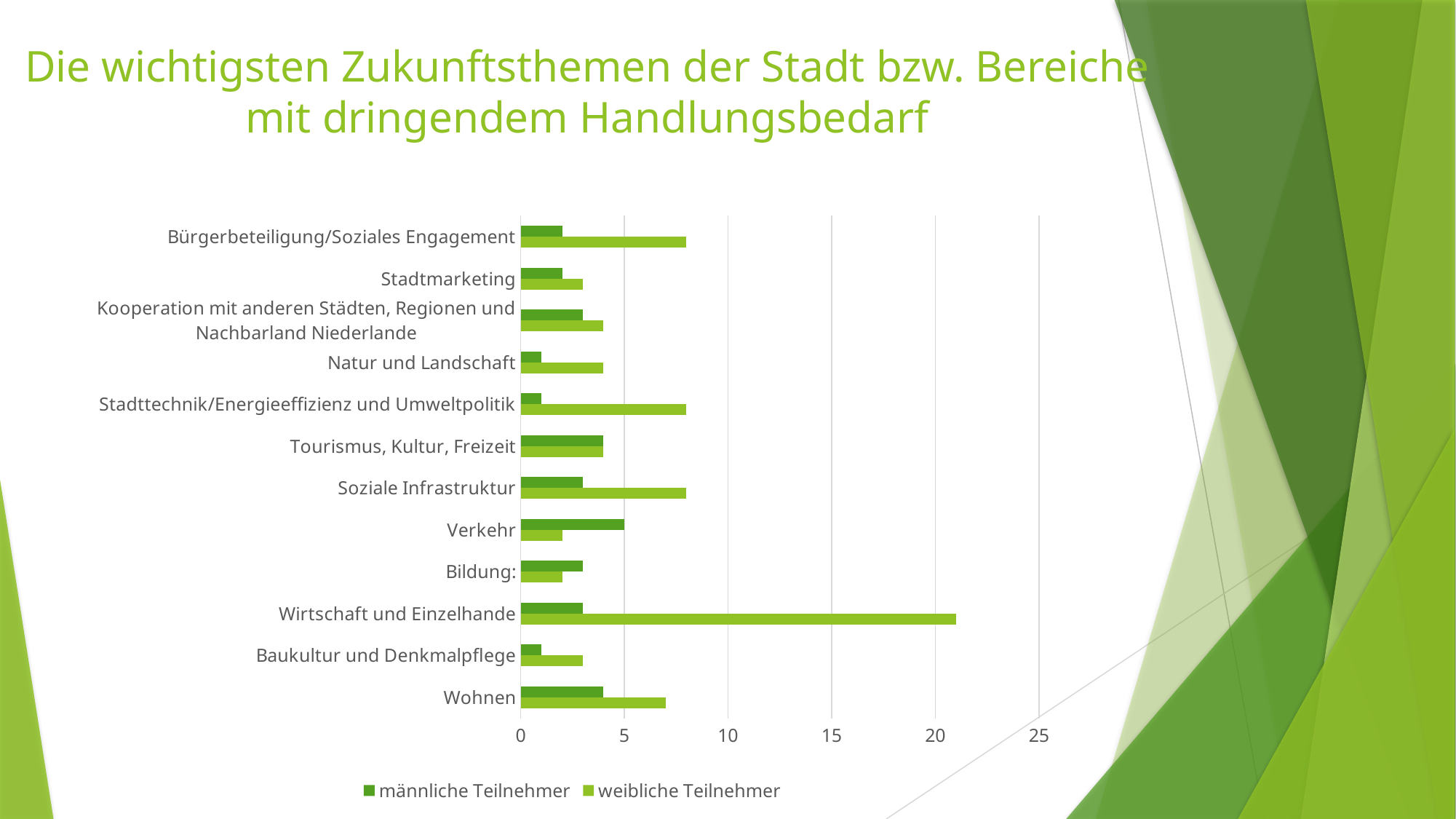
Is the value for weibliche Teilnehmer in Wirtschaft und Einzelhande greater or less than 20? greater Is the value for männliche Teilnehmer in Natur und Landschaft greater or less than 5? less Which category has the longest bar for weibliche Teilnehmer? Wirtschaft und Einzelhande What kind of chart is shown on the slide? bar chart For Bürgerbeteiligung/Soziales Engagement, which series has the larger value, männliche Teilnehmer or weibliche Teilnehmer? weibliche Teilnehmer For Verkehr, which series has the larger value, männliche Teilnehmer or weibliche Teilnehmer? männliche Teilnehmer Is the value for weibliche Teilnehmer in Verkehr greater or less than 5? less Which series is shown in the darker green colour in the legend? männliche Teilnehmer How many categories are shown on the chart? 12 How many series does the legend list? 2